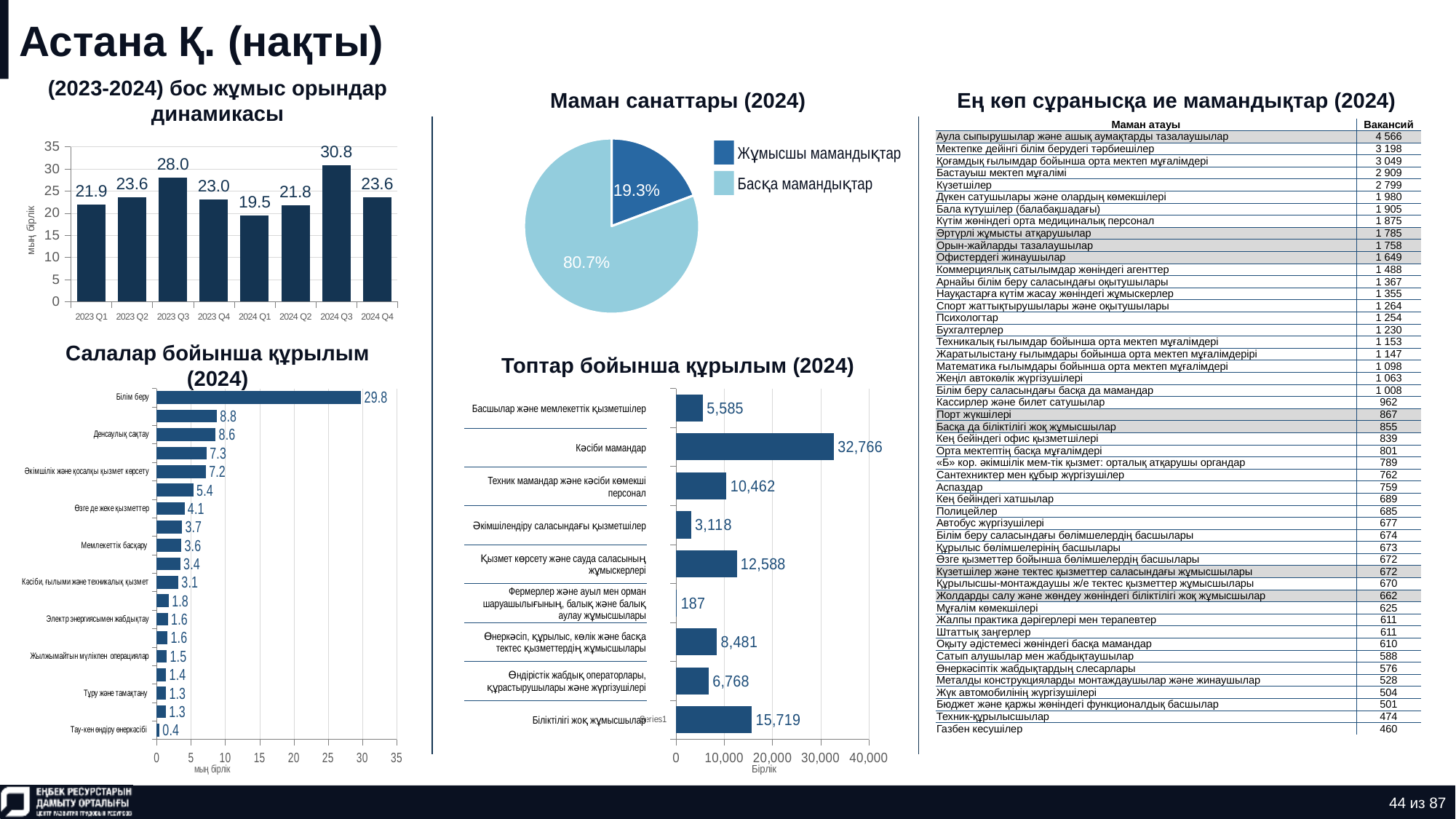
In the chart '(2023-2024) бос жұмыс орындар динамикасы', what is the value for 2024 Q3? 30.8 In the chart '(2023-2024) бос жұмыс орындар динамикасы', what is the difference between 2023 Q3 and 2023 Q4? 5.0 In the chart 'Маман санаттары (2024)', what share does 'Жұмысшы мамандықтар' have? 19.3% In the chart '(2023-2024) бос жұмыс орындар динамикасы', how many quarters are plotted? 8 What kind of chart is 'Маман санаттары (2024)'? pie chart In the chart 'Топтар бойынша құрылым (2024)', which is larger: 'Біліктілігі жоқ жұмысшылар' or 'Қызмет көрсету және сауда саласының жұмыскерлері'? Біліктілігі жоқ жұмысшылар In the chart '(2023-2024) бос жұмыс орындар динамикасы', which quarter has the lowest value? 2024 Q1 In the chart 'Топтар бойынша құрылым (2024)', what is the value for 'Кәсіби мамандар'? 32,766 In the chart 'Топтар бойынша құрылым (2024)', which category has the lowest value? Фермерлер және ауыл мен орман шаруашылығының, балық және балық аулау жұмысшылары In the chart 'Салалар бойынша құрылым (2024)', which category has the highest value? Білім беру In the chart 'Топтар бойынша құрылым (2024)', how many categories are plotted? 9 In the chart 'Салалар бойынша құрылым (2024)', what is the value for 'Тау-кен өндіру өнеркәсібі'? 0.4